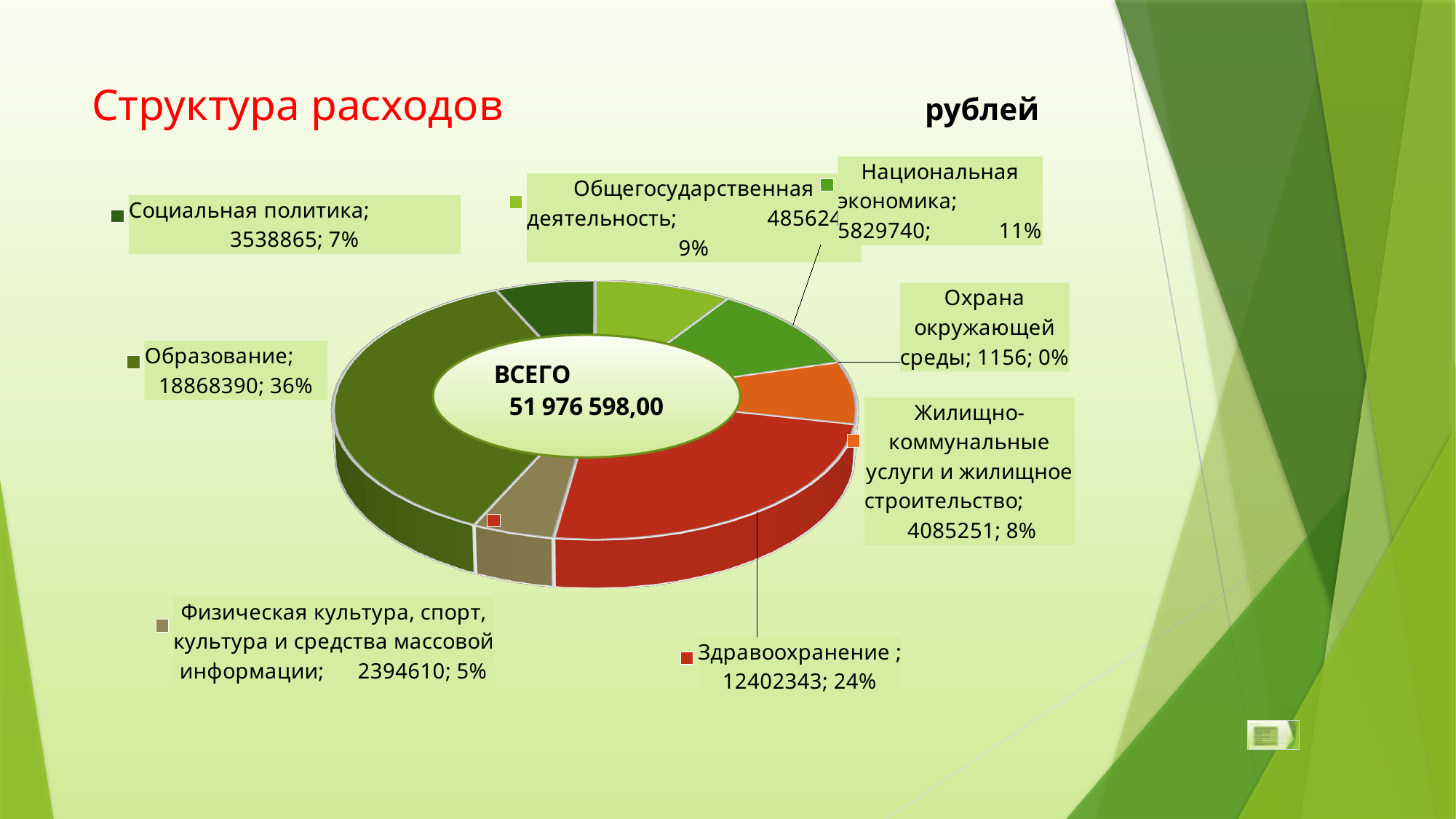
How many categories does the chart show? 8 Which category has the smallest share of expenditures? Охрана окружающей среды Which category has the largest share of expenditures? Образование What is the value for Охрана окружающей среды? 1156 What share of the total does Здравоохранение account for? 24% What is the total (ВСЕГО) shown in the centre of the chart? 51 976 598,00 What is the title of the chart? Структура расходов What is the value for Национальная экономика? 5829740 What is the difference between the values for Здравоохранение and Национальная экономика? 6572603 What is the value for Образование? 18868390 Which is larger: Социальная политика or Жилищно-коммунальные услуги и жилищное строительство? Жилищно-коммунальные услуги и жилищное строительство What kind of chart is shown on the slide? doughnut (pie) chart